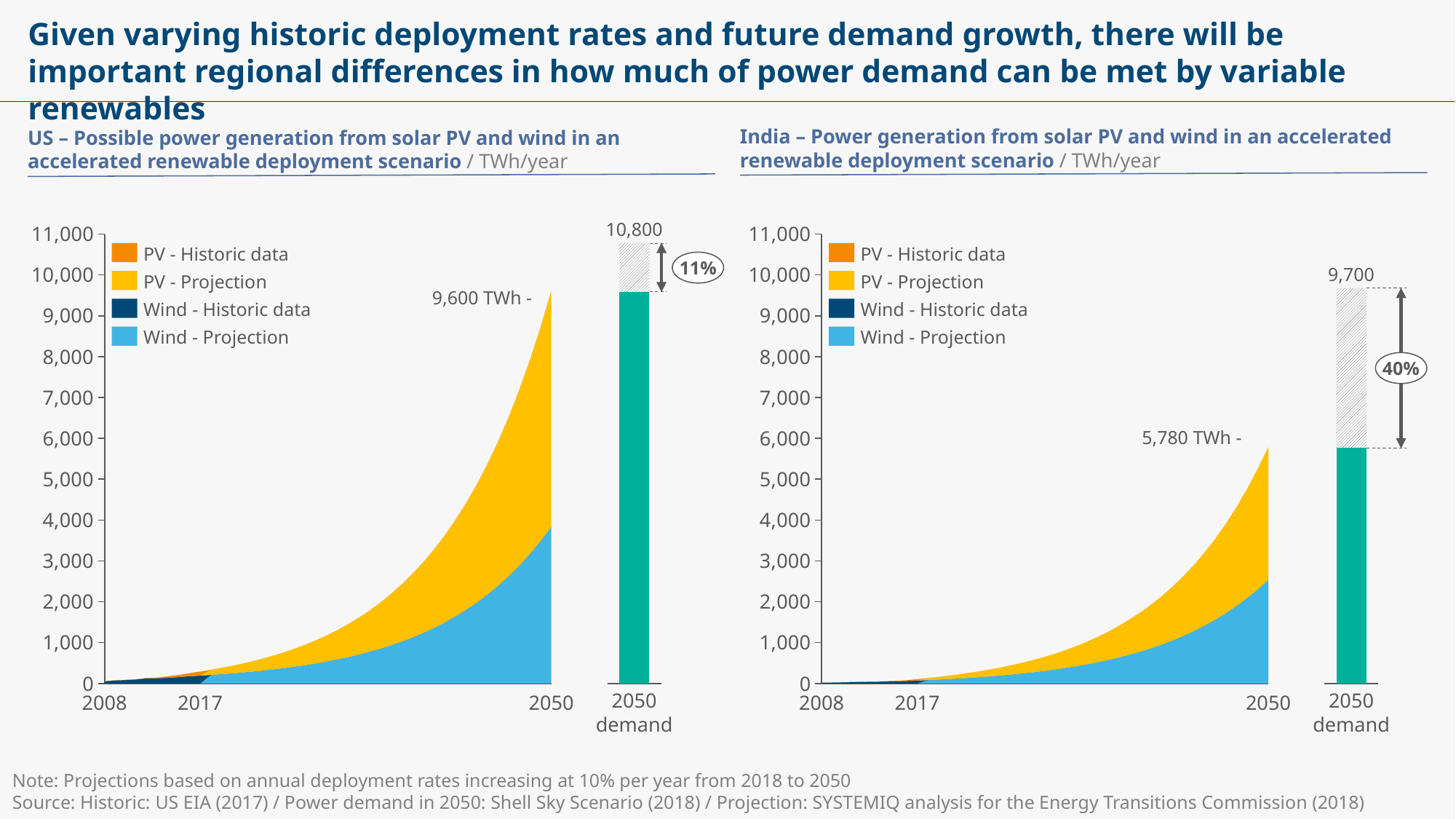
In the India chart, what percentage is shown for the gap between 2050 demand and 2050 solar PV and wind generation? 40% In the US chart, what percentage is shown for the gap between 2050 demand and 2050 solar PV and wind generation? 11% In the US chart, what value is shown for 2050 demand? 10,800 Which chart shows the larger labelled solar PV and wind generation in 2050, the US chart or the India chart? US chart In the India chart, what value is shown for 2050 demand? 9,700 In the India chart, what is the difference between 2050 demand and the 2050 solar PV and wind generation? 3,920 In the US chart, does the combined solar PV and wind generation rise or fall from 2008 to 2050? rise In the US chart, what is the difference between 2050 demand and the 2050 solar PV and wind generation? 1,200 How many series does the legend of the US chart list? 4 In the India chart, is the Wind - Projection value in 2050 greater or less than 3,000? less In the India chart, what is the labelled total power generation from solar PV and wind in 2050? 5,780 TWh In the US chart, what is the labelled total power generation from solar PV and wind in 2050? 9,600 TWh